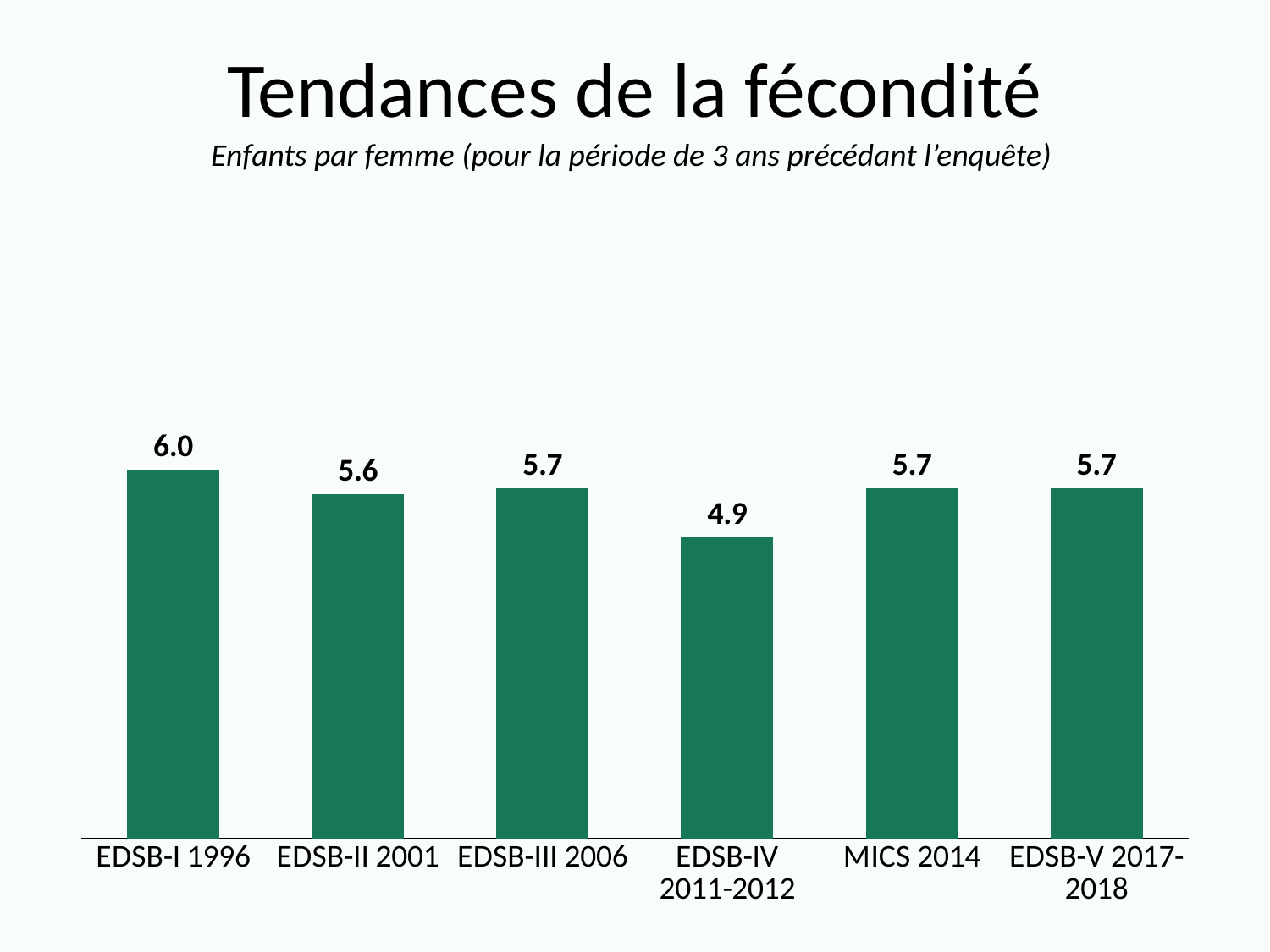
Which survey has the highest value? EDSB-I 1996 What kind of chart is shown on the slide? Bar chart What is the value for EDSB-II 2001? 5.6 What is the difference between the values for EDSB-I 1996 and EDSB-IV 2011-2012? 1.1 What is the value for EDSB-V 2017-2018? 5.7 What is the value for EDSB-IV 2011-2012? 4.9 Which survey has the lowest value? EDSB-IV 2011-2012 What is the title of the chart? Tendances de la fécondité How many surveys are shown on the chart? 6 What is the difference between the values for EDSB-III 2006 and EDSB-II 2001? 0.1 Which is larger, the value for EDSB-II 2001 or the value for EDSB-IV 2011-2012? EDSB-II 2001 What is the value for EDSB-I 1996? 6.0